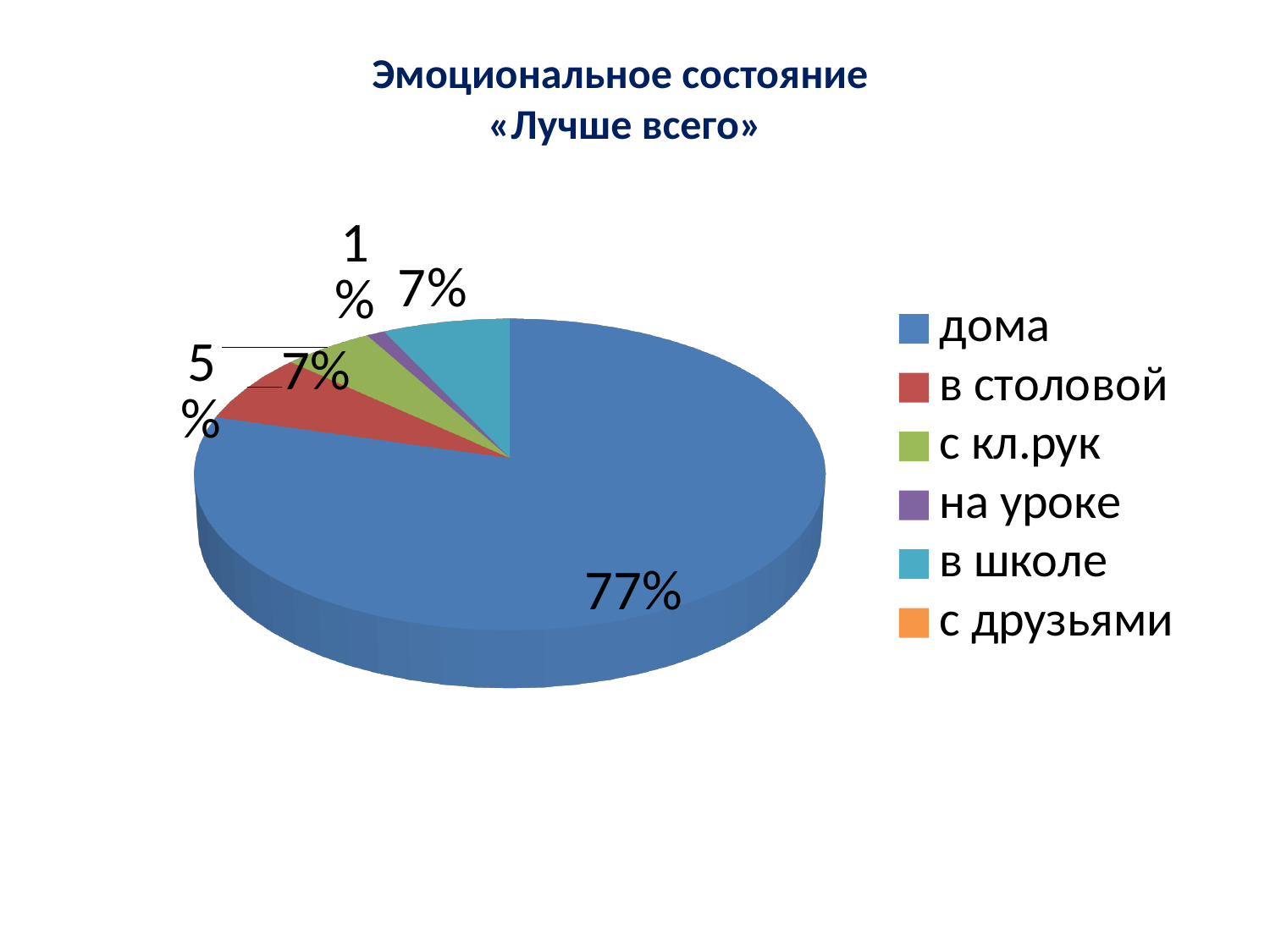
What share of the pie does «в столовой» have? 7% Which category has the largest share of the pie? дома What share of the pie does «на уроке» have? 1% How many entries does the legend list? 6 Which is larger, the share for «дома» or the share for «в столовой»? дома Which is larger, the share for «в школе» or the share for «на уроке»? в школе What colour is the slice for «дома»? blue What share of the pie does «дома» have? 77% What is the difference in percentage points between the share for «дома» and the share for «в школе»? 70 What is the title of the chart? Эмоциональное состояние «Лучше всего» What share of the pie does «в школе» have? 7% What kind of chart is shown on the slide? pie chart